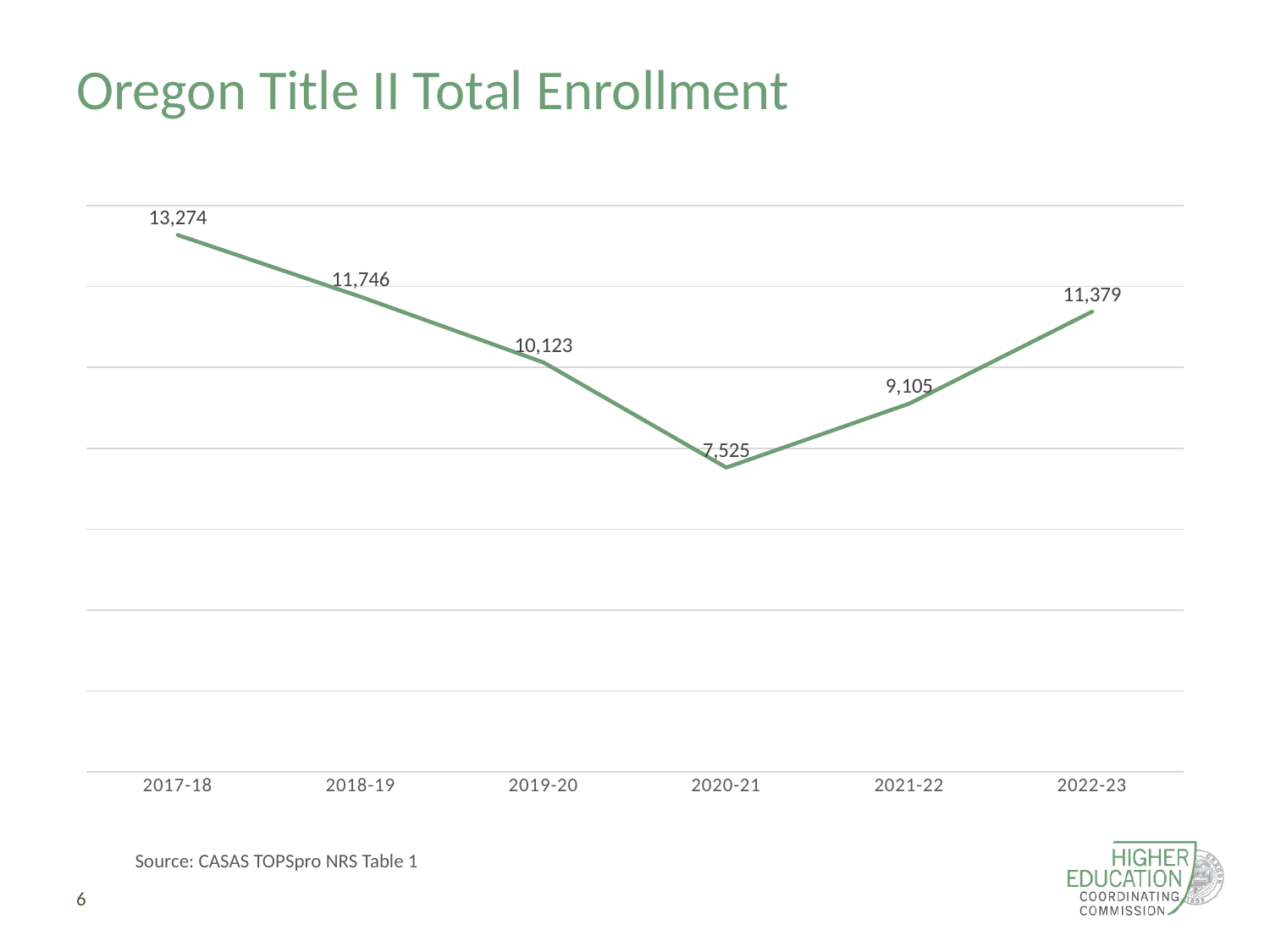
Which year had higher enrollment, 2018-19 or 2022-23? 2018-19 By how much did enrollment increase from 2021-22 to 2022-23? 2,274 What was the Oregon Title II total enrollment in 2019-20? 10,123 Which year had the highest total enrollment? 2017-18 How did enrollment change from 2017-18 to 2020-21? It fell What kind of chart is shown on the slide? Line chart Which year had the lowest total enrollment? 2020-21 What was the Oregon Title II total enrollment in 2022-23? 11,379 What is the difference in enrollment between 2017-18 and 2020-21? 5,749 How many years are plotted on the chart? 6 What was the Oregon Title II total enrollment in 2020-21? 7,525 What was the Oregon Title II total enrollment in 2017-18? 13,274